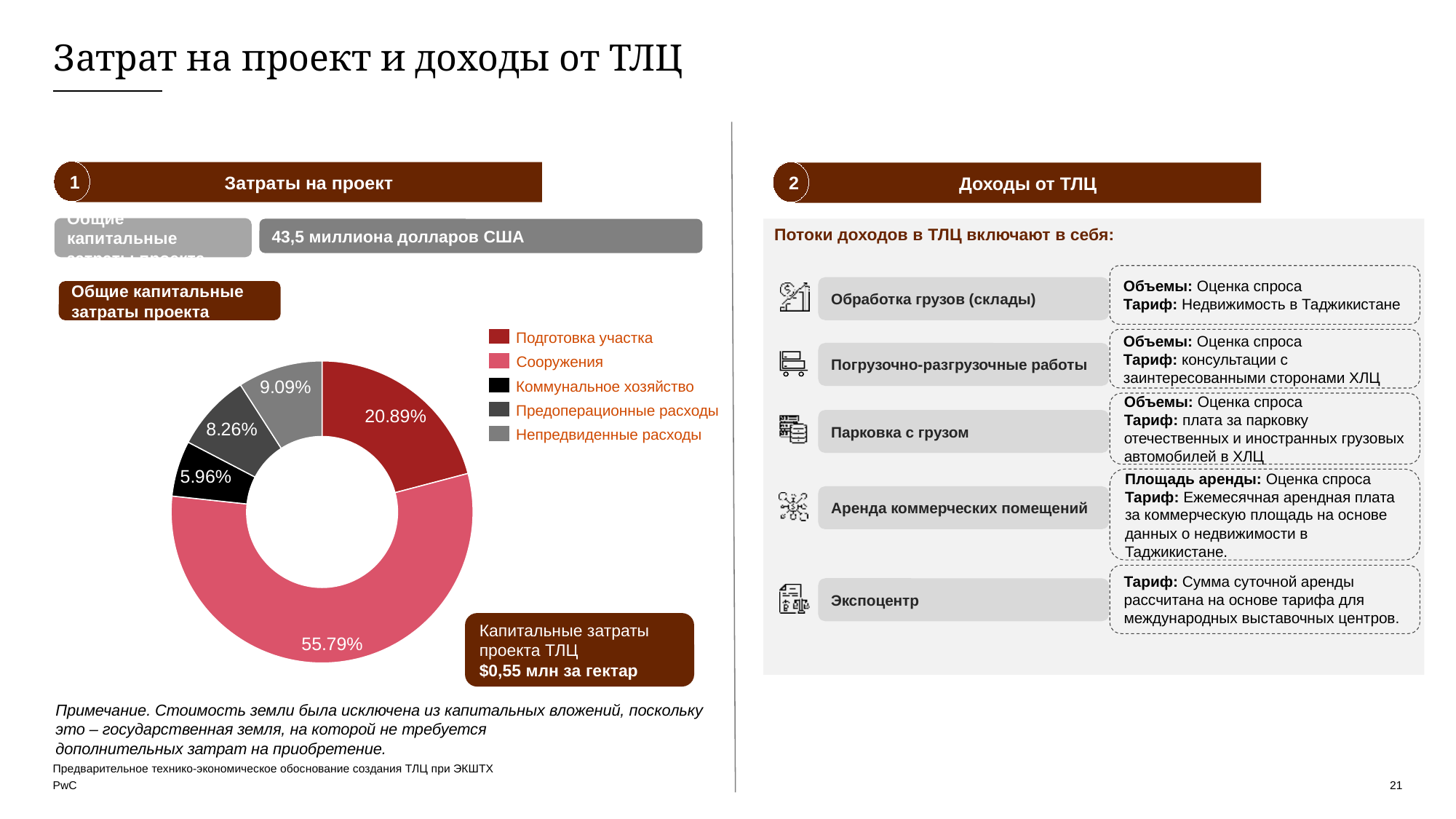
Which category has the smallest share in the donut chart? Коммунальное хозяйство What is the difference in percentage points between Сооружения and Подготовка участка in the donut chart? 34.90 How many categories does the donut chart show? 5 What share of the donut chart is labelled Сооружения? 55.79% Which category has the largest share in the donut chart? Сооружения What share of the donut chart is labelled Коммунальное хозяйство? 5.96% What type of chart is shown on the slide? Donut (pie) chart What share of the donut chart is labelled Подготовка участка? 20.89% What share of the donut chart is labelled Непредвиденные расходы? 9.09% What share of the donut chart is labelled Предоперационные расходы? 8.26% What colour is the Сооружения slice in the donut chart? Pink (light red) Which is larger in the donut chart: Непредвиденные расходы or Предоперационные расходы? Непредвиденные расходы